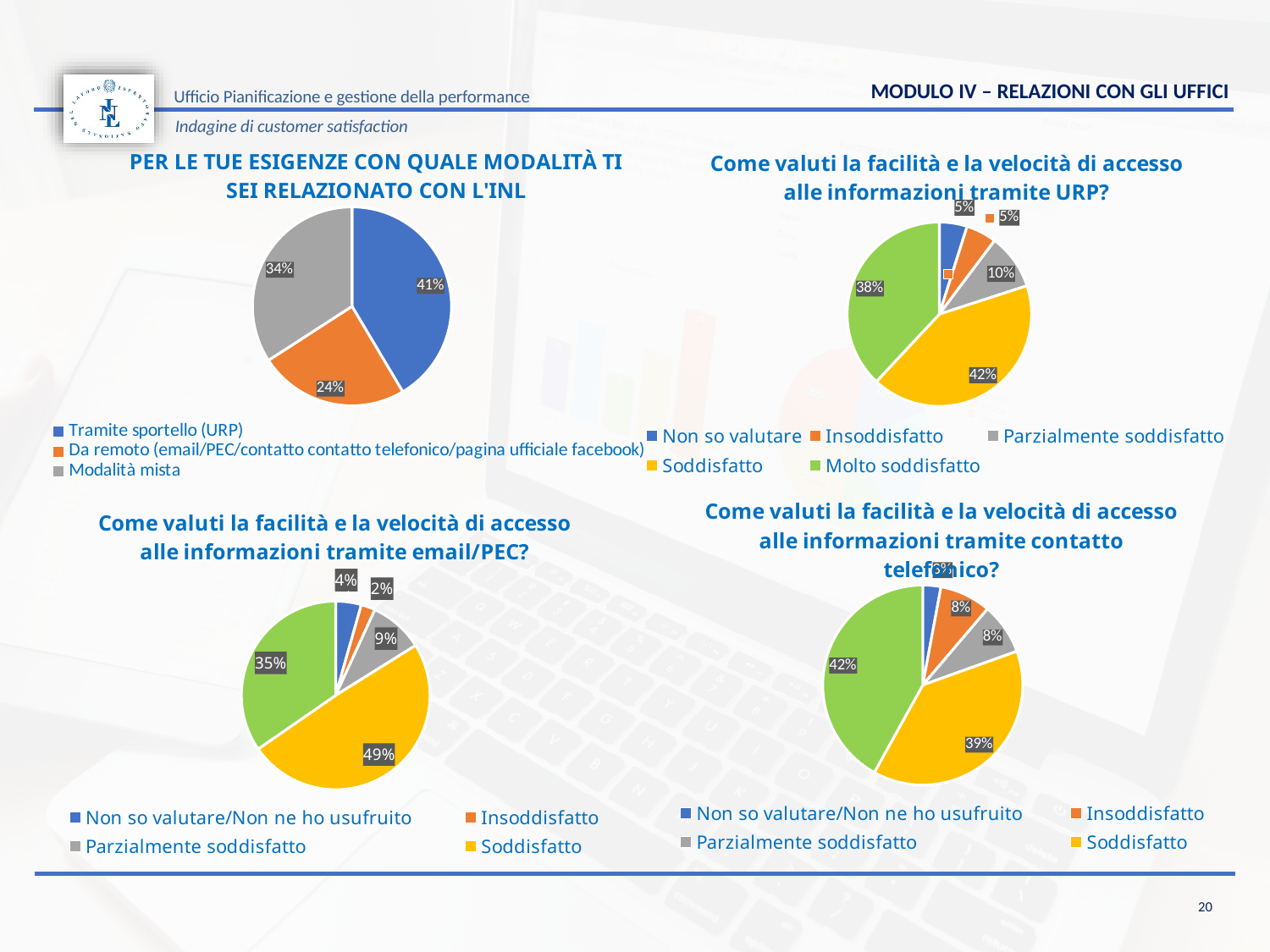
In the chart about access to information 'tramite URP', how many entries does the legend list? 5 In the chart about access to information 'tramite URP', what share is 'Soddisfatto'? 42% In the chart titled 'PER LE TUE ESIGENZE CON QUALE MODALITÀ TI SEI RELAZIONATO CON L'INL', which category has the smallest share? Da remoto (email/PEC/contatto contatto telefonico/pagina ufficiale facebook) In the chart titled 'PER LE TUE ESIGENZE CON QUALE MODALITÀ TI SEI RELAZIONATO CON L'INL', how many categories are shown? 3 In the chart titled 'PER LE TUE ESIGENZE CON QUALE MODALITÀ TI SEI RELAZIONATO CON L'INL', what share is 'Modalità mista'? 34% In the chart about access to information 'tramite URP', what is the difference between 'Soddisfatto' and 'Molto soddisfatto'? 4% In the chart about access to information 'tramite contatto telefonico', what share is 'Soddisfatto'? 39% What type of chart is used for the chart about access to information 'tramite contatto telefonico'? Pie chart In the chart about access to information 'tramite email/PEC', which is larger: 'Insoddisfatto' or 'Parzialmente soddisfatto'? Parzialmente soddisfatto In the chart titled 'PER LE TUE ESIGENZE CON QUALE MODALITÀ TI SEI RELAZIONATO CON L'INL', what share is 'Tramite sportello (URP)'? 41% In the chart about access to information 'tramite URP', what share is 'Parzialmente soddisfatto'? 10% In the chart about access to information 'tramite email/PEC', what share is 'Soddisfatto'? 49%